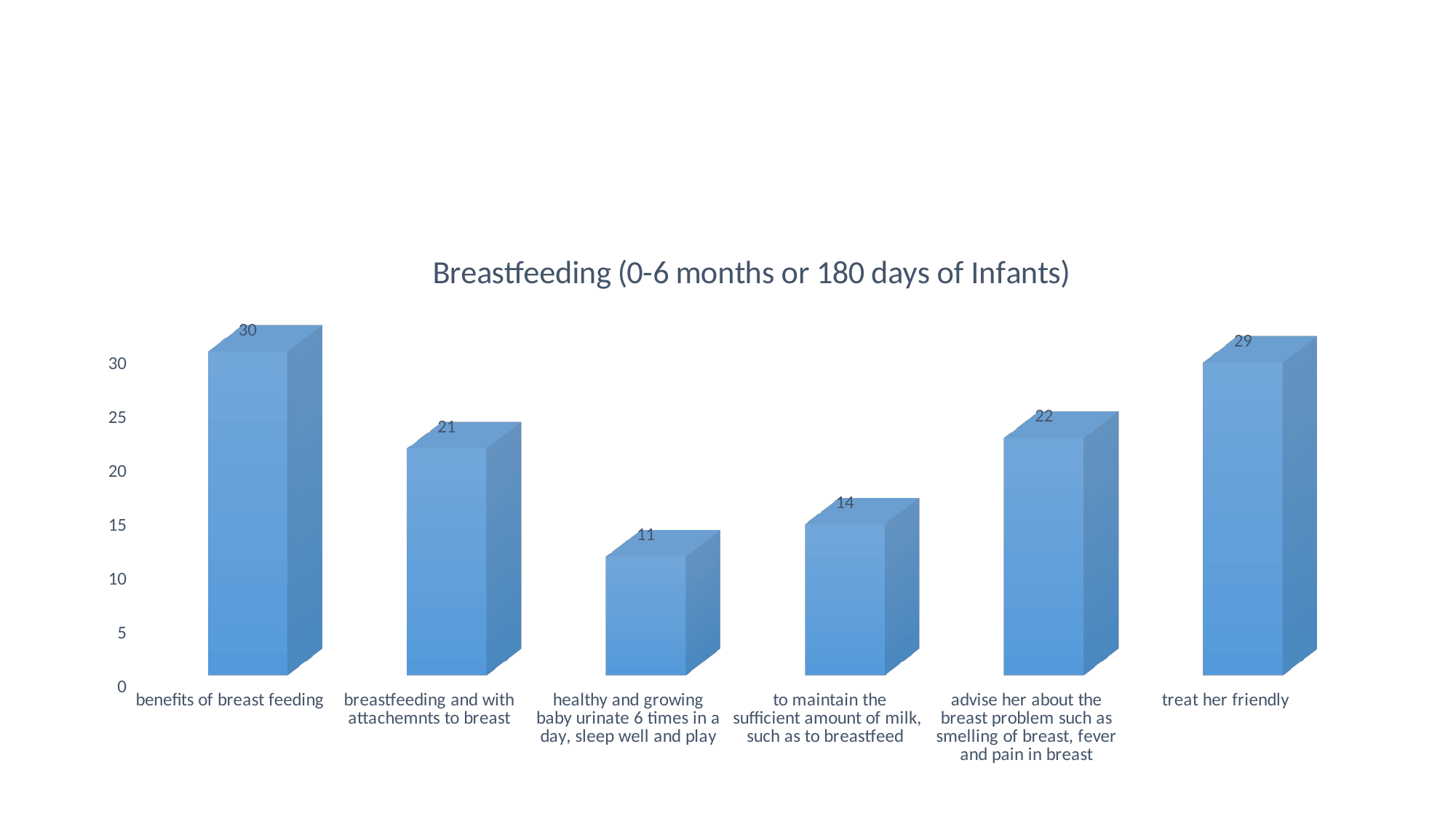
What is the value for "treat her friendly"? 29 How many categories are shown on the chart? 6 What is the difference between the values for "treat her friendly" and "advise her about the breast problem such as smelling of breast, fever and pain in breast"? 7 Which category has the highest value? benefits of breast feeding Which category has the lowest value? healthy and growing baby urinate 6 times in a day, sleep well and play What is the title of the chart? Breastfeeding (0-6 months or 180 days of Infants) What is the value for "benefits of breast feeding"? 30 Is the value for "breastfeeding and with attachemnts to breast" greater or less than 25? less What kind of chart is shown on the slide? bar chart What is the value for "to maintain the sufficient amount of milk, such as to breastfeed"? 14 Which is larger: the value for "advise her about the breast problem such as smelling of breast, fever and pain in breast" or the value for "to maintain the sufficient amount of milk, such as to breastfeed"? advise her about the breast problem such as smelling of breast, fever and pain in breast What is the difference between the values for "benefits of breast feeding" and "breastfeeding and with attachemnts to breast"? 9